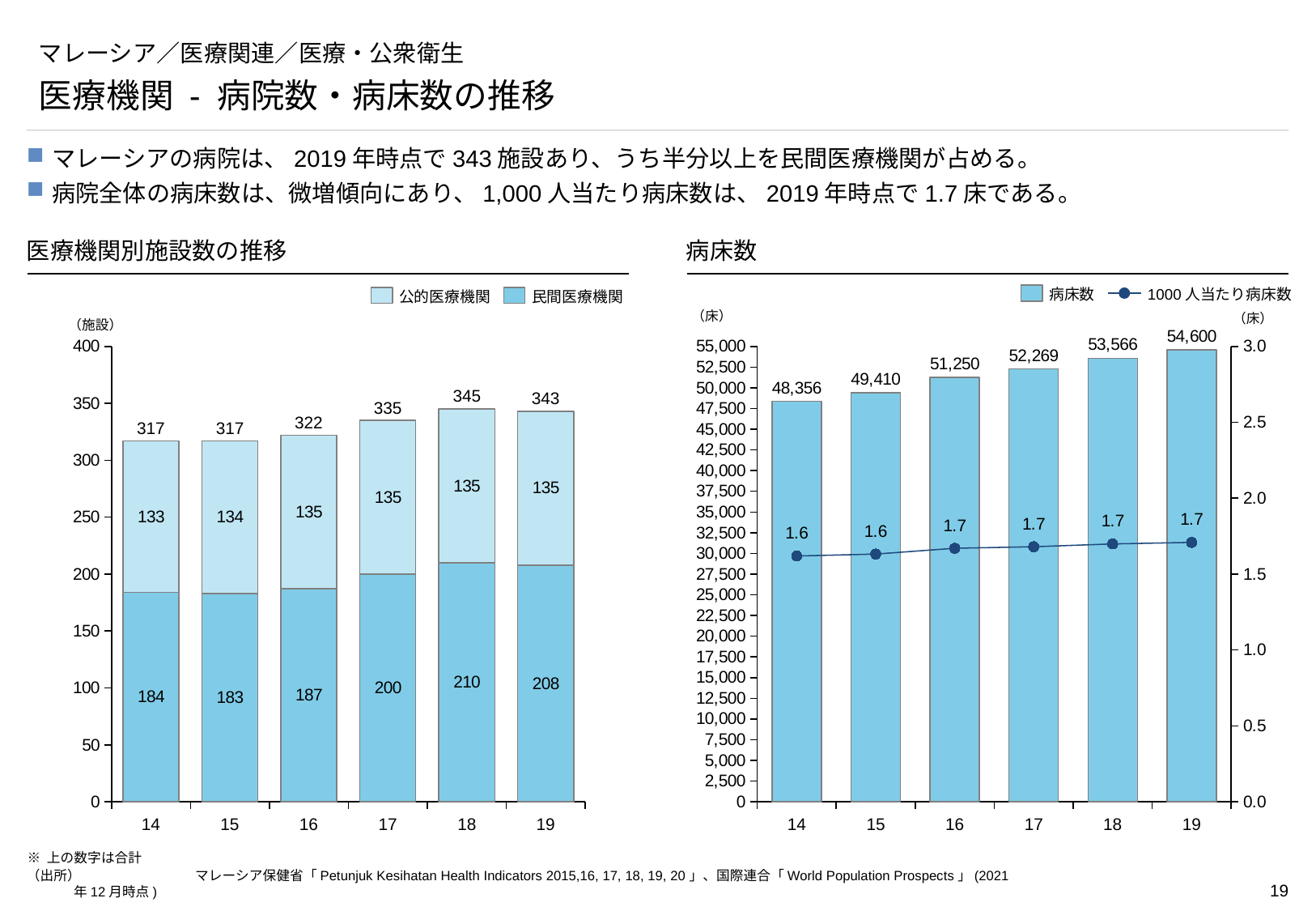
In the 病床数 chart, what is the value for 病床数 in 16? 51,250 In the 病床数 chart, what is the difference in 病床数 between 19 and 18? 1,034 In the 病床数 chart, which year has the lowest 病床数? 14 In the 医療機関別施設数の推移 chart, which year has the highest total? 18 In the 病床数 chart, what is the value for 1000 人当たり病床数 in 14? 1.6 In the 医療機関別施設数の推移 chart, what is the value for 公的医療機関 in 14? 133 In the 医療機関別施設数の推移 chart, what is the value for 民間医療機関 in 19? 208 In the 病床数 chart, do the 病床数 values rise or fall from 14 to 19? rise In the 医療機関別施設数の推移 chart, how many series does the legend list? 2 In the 医療機関別施設数の推移 chart, what is the difference between 民間医療機関 and 公的医療機関 in 17? 65 In the 医療機関別施設数の推移 chart, what is the total of the stacked bar for 18? 345 In the 病床数 chart, how many years are shown on the x axis? 6